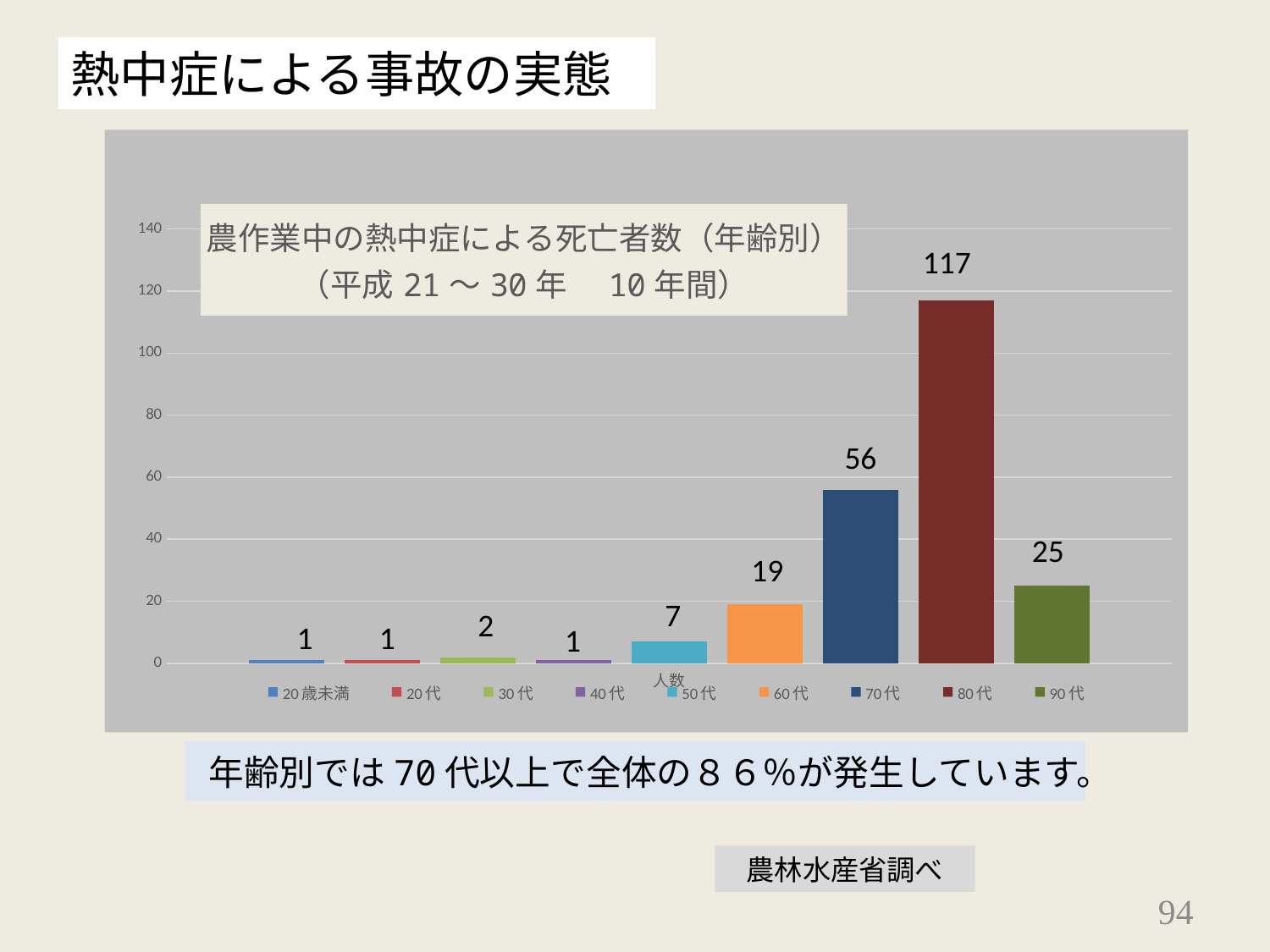
Which is larger, the value for 70代 or the value for 90代? 70代 What is the value for 50代 in the chart? 7 What kind of chart is shown on the slide? bar chart What is the difference between the values for 90代 and 60代? 6 Which age group has the highest value in the chart? 80代 How many entries does the chart legend list? 9 What is the title of the chart? 農作業中の熱中症による死亡者数（年齢別）（平成21～30年 10年間） What is the difference between the values for 80代 and 70代? 61 How many age-group categories are shown in the chart? 9 Is the value for 80代 greater or less than 100? greater What is the value for 60代 in the chart? 19 What is the value for 80代 in the chart? 117